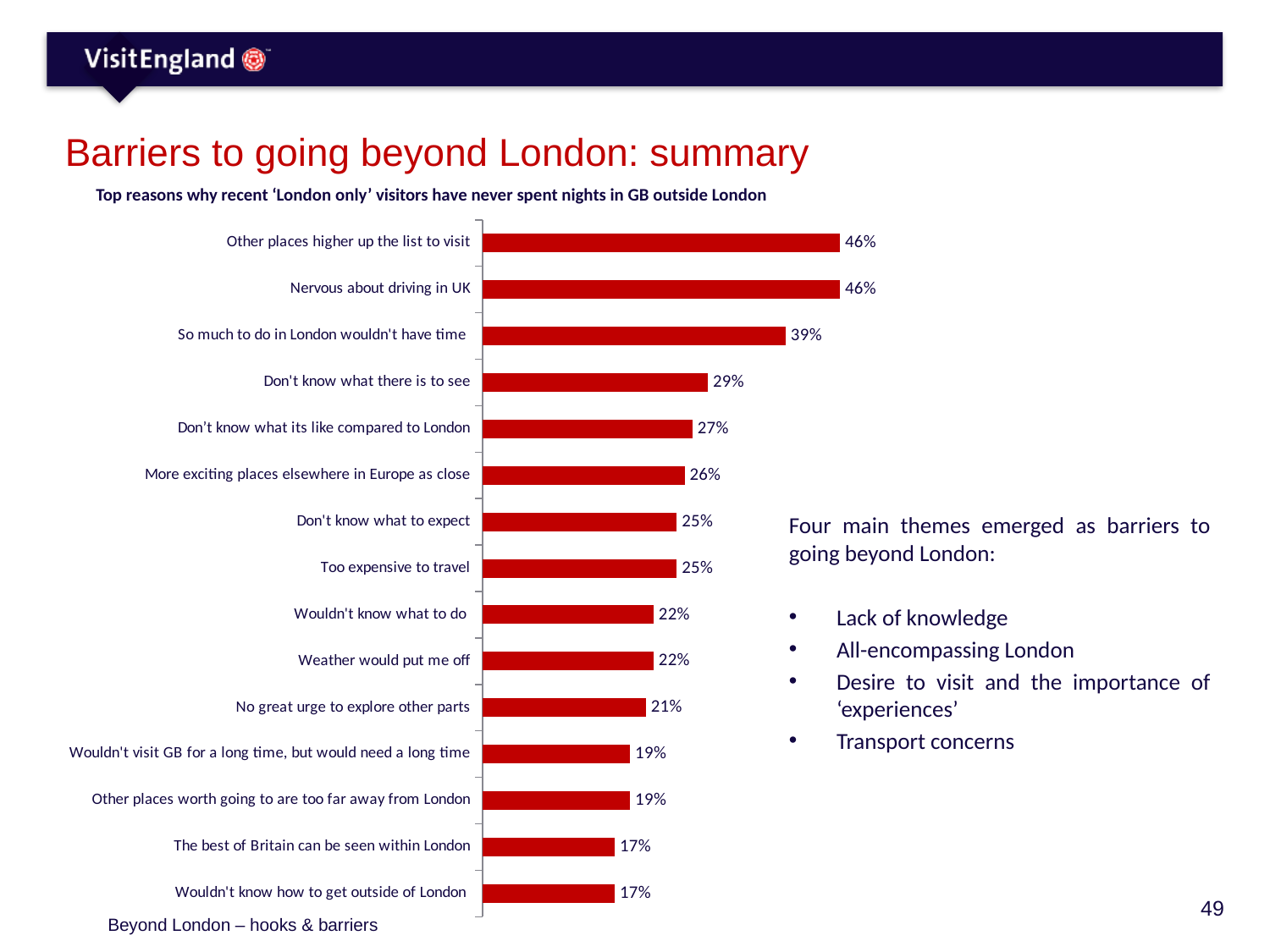
What percentage of recent 'London only' visitors cited 'Nervous about driving in UK' as a reason? 46% What is the title of the chart? Top reasons why recent 'London only' visitors have never spent nights in GB outside London What is the value for 'So much to do in London wouldn't have time'? 39% Which is larger: 'Too expensive to travel' or 'No great urge to explore other parts'? Too expensive to travel What is the value for 'Weather would put me off'? 22% What is the value for 'Wouldn't know how to get outside of London'? 17% How many reasons (categories) are shown on the chart? 15 Which is larger: 'Don't know what there is to see' or 'More exciting places elsewhere in Europe as close'? Don't know what there is to see What is the difference between 'Other places higher up the list to visit' and 'Don't know what there is to see'? 17% What is the highest percentage shown on the chart? 46% What type of chart is shown on the slide? Bar chart What is the lowest percentage shown on the chart? 17%